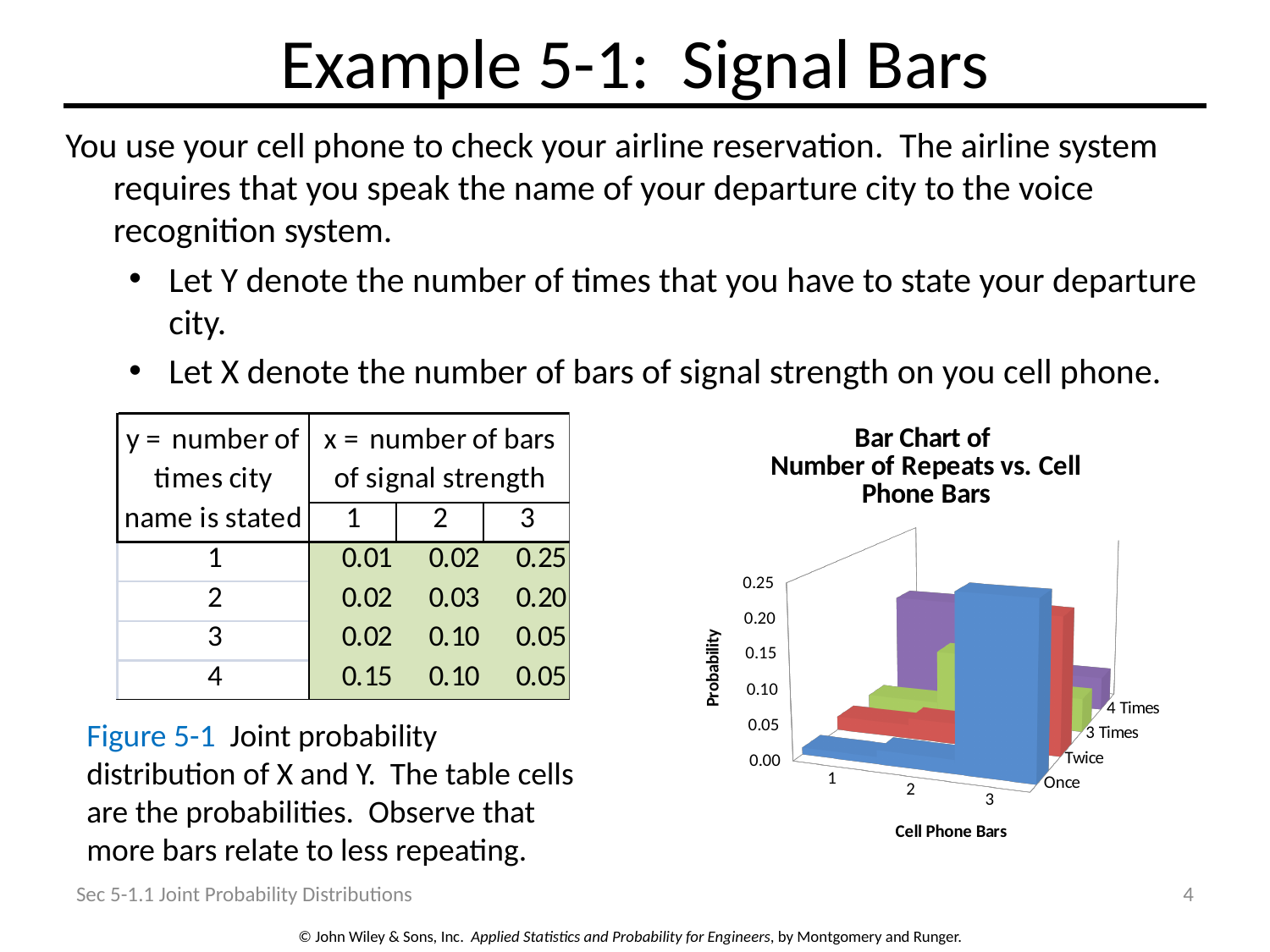
Is the probability for 3 cell phone bars and Once greater or less than 0.20? greater How many categories are shown on the Cell Phone Bars axis of the chart? 3 Which combination of cell phone bars and repeats has the highest probability in the chart? 3 bars, Once What is the probability for 1 cell phone bar and 4 Times, as given in the table on the slide? 0.15 Which is larger: the probability for 3 bars and Once, or the probability for 1 bar and Once? 3 bars and Once What kind of chart is shown on the slide? bar chart What is the probability for 3 cell phone bars and Once, as given in the table on the slide? 0.25 What is the label of the vertical axis of the chart? Probability Is the probability for 1 cell phone bar and 4 Times greater or less than 0.10? greater Is the probability for 1 cell phone bar and Once greater or less than 0.05? less How many repeat categories (Once, Twice, 3 Times, 4 Times) are plotted in the chart? 4 What is the title of the chart on the slide? Bar Chart of Number of Repeats vs. Cell Phone Bars